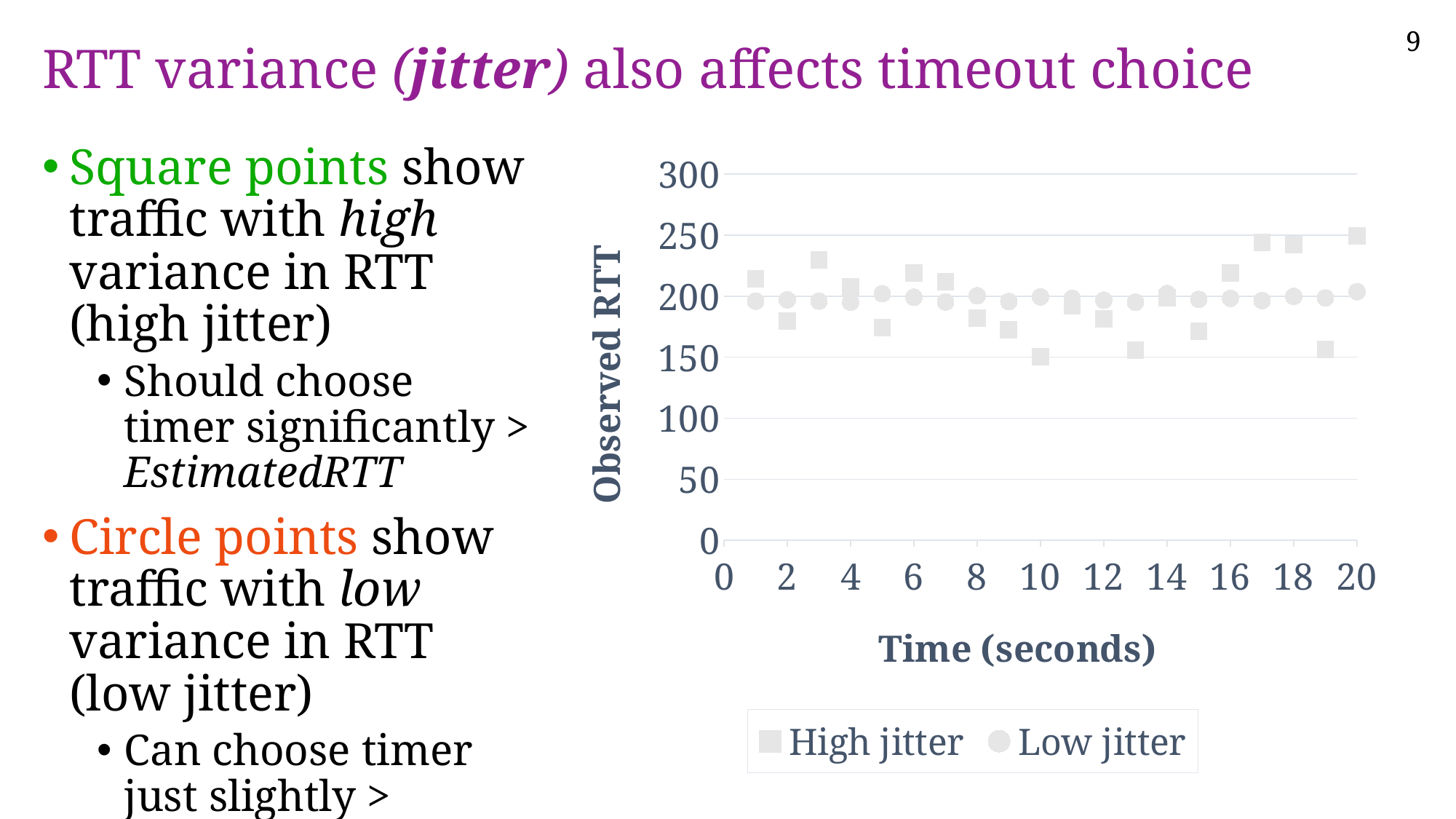
What is the title of the chart's vertical axis? Observed RTT How many series does the chart's legend list? 2 What are the two series named in the chart's legend? High jitter and Low jitter At time 20 seconds, which series has the larger Observed RTT, High jitter or Low jitter? High jitter Is the High jitter value at time 10 seconds greater or less than 200? less How many High jitter points are plotted on the chart? 20 Which series contains the highest Observed RTT point on the chart? High jitter At time 10 seconds, which series has the larger Observed RTT, High jitter or Low jitter? Low jitter What kind of chart is shown on the slide? scatter chart Is the High jitter value at time 3 seconds greater or less than 200? greater Is the High jitter value at time 20 seconds greater or less than 200? greater